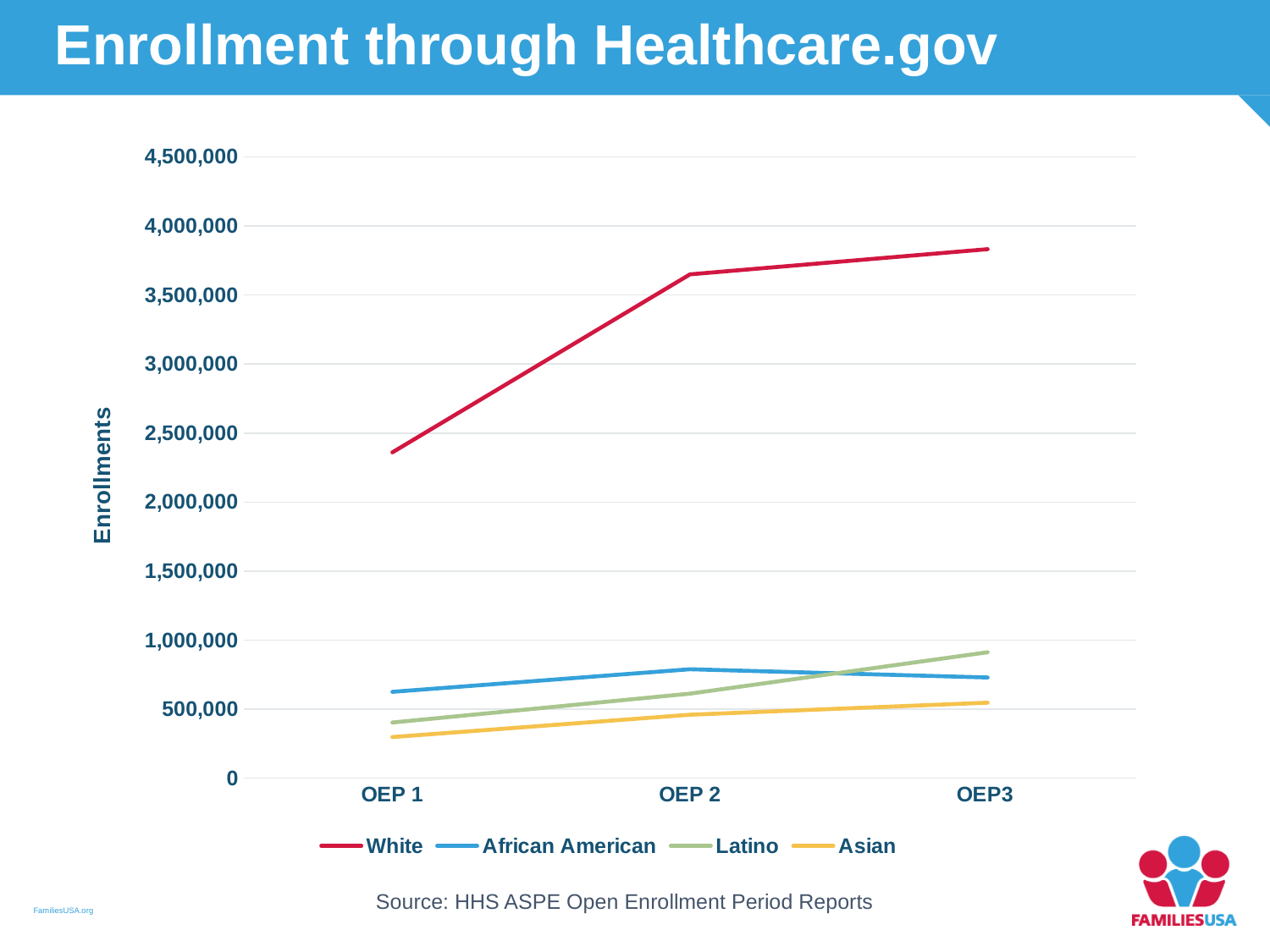
How many series does the legend list? 4 What kind of chart is shown on the slide? Line chart What is the label on the vertical axis? Enrollments Which group has the lowest enrollment at OEP 1? Asian At OEP3, which is larger: Latino enrollment or African American enrollment? Latino Is the value for White at OEP 1 greater or less than 2,500,000? less Which group has the highest enrollment at OEP3? White Is the value for Latino at OEP3 greater or less than 1,000,000? less Is the value for African American at OEP 1 greater or less than 500,000? greater Does the White enrollment line rise or fall from OEP 1 to OEP3? Rise How many open enrollment periods are shown on the x axis? 3